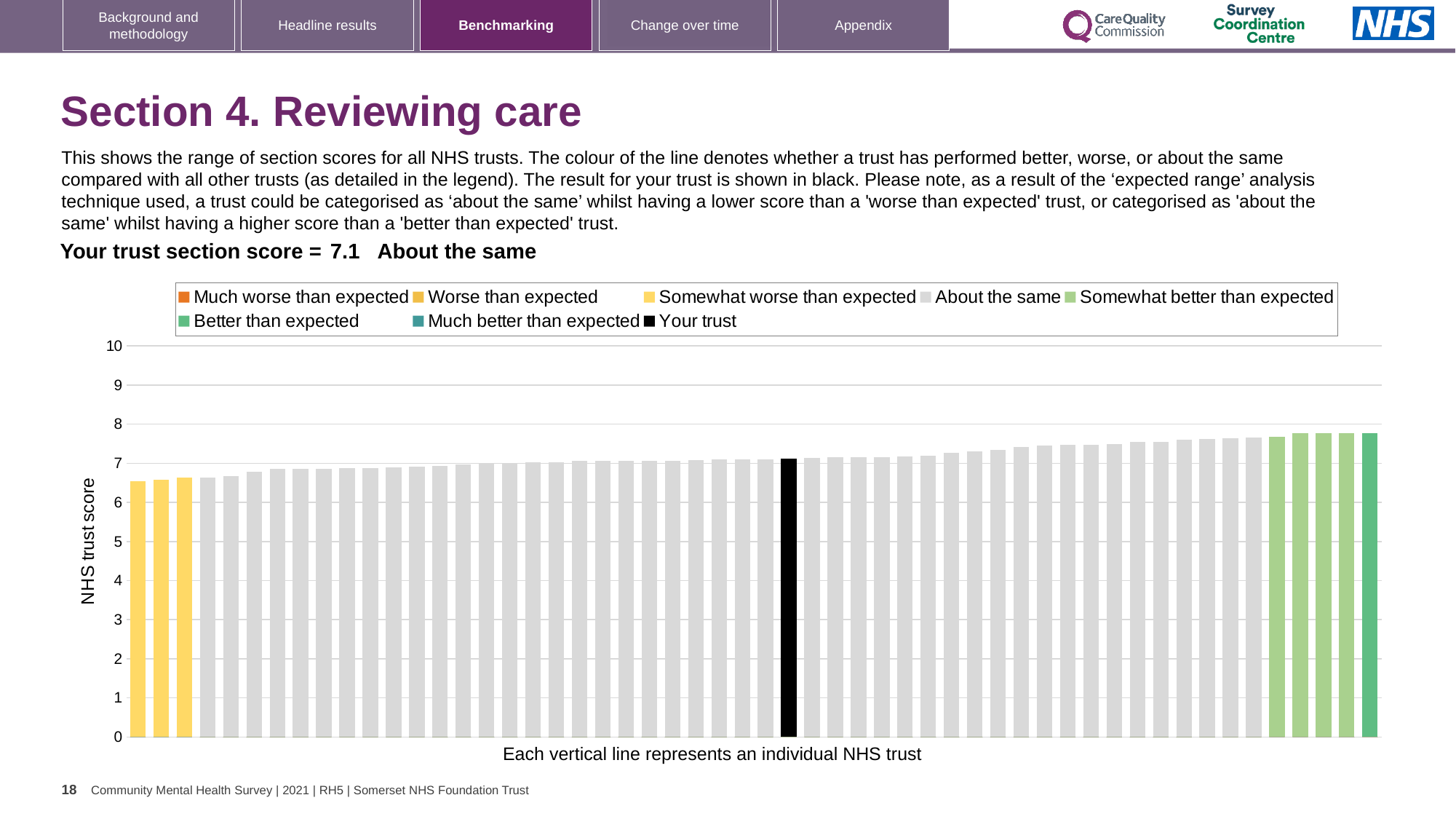
What is the section score for your trust shown on the slide? 7.1 Is the value of the lowest bar in the chart greater or less than 6? greater What is the label on the vertical axis of the chart? NHS trust score What kind of chart is shown on the slide? Bar chart Which is higher: the black bar for your trust or the yellow bars at the left of the chart? Your trust Do the bar values rise or fall moving from left to right along the x axis? Rise Which performance category is your trust placed in for this section? About the same How many entries does the chart legend list? 8 What colour is the bar representing your trust? Black Is the value of the highest bar in the chart greater or less than 8? less Is the value for your trust greater or less than 5? greater How many bars in the chart are coloured yellow? 3